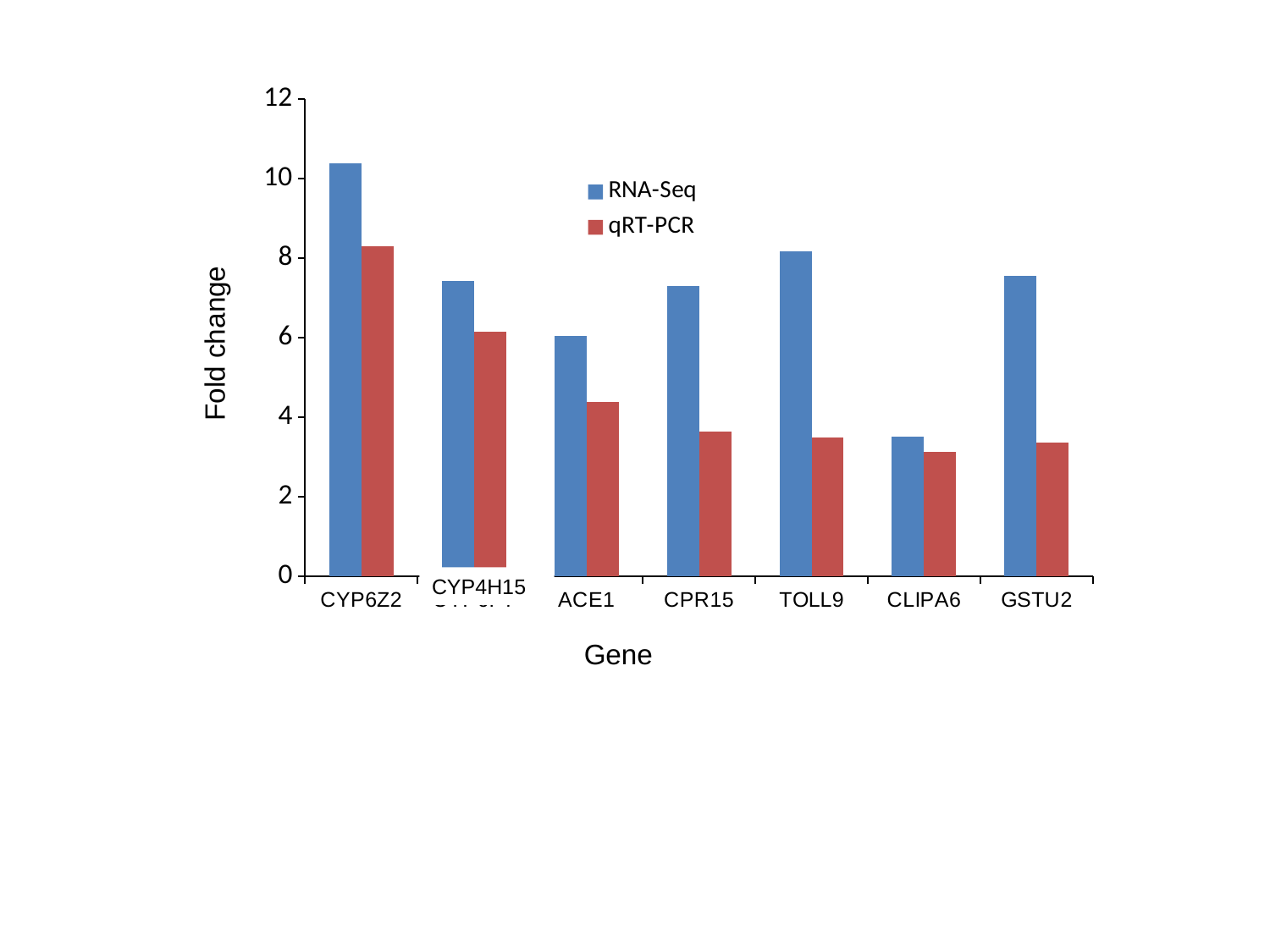
How many series does the legend list? 2 What is the label of the y axis? Fold change What type of chart is shown on the slide? bar chart Is the qRT-PCR fold change for CPR15 greater or less than 4? less Is the qRT-PCR fold change for CYP4H15 greater or less than 4? greater Which gene has the highest qRT-PCR fold change? CYP6Z2 Is the RNA-Seq fold change for CLIPA6 greater or less than 4? less Which gene has the lowest RNA-Seq fold change? CLIPA6 Which gene has the highest RNA-Seq fold change? CYP6Z2 How many genes are shown on the x axis? 7 Which is larger, the RNA-Seq fold change for TOLL9 or the RNA-Seq fold change for ACE1? TOLL9